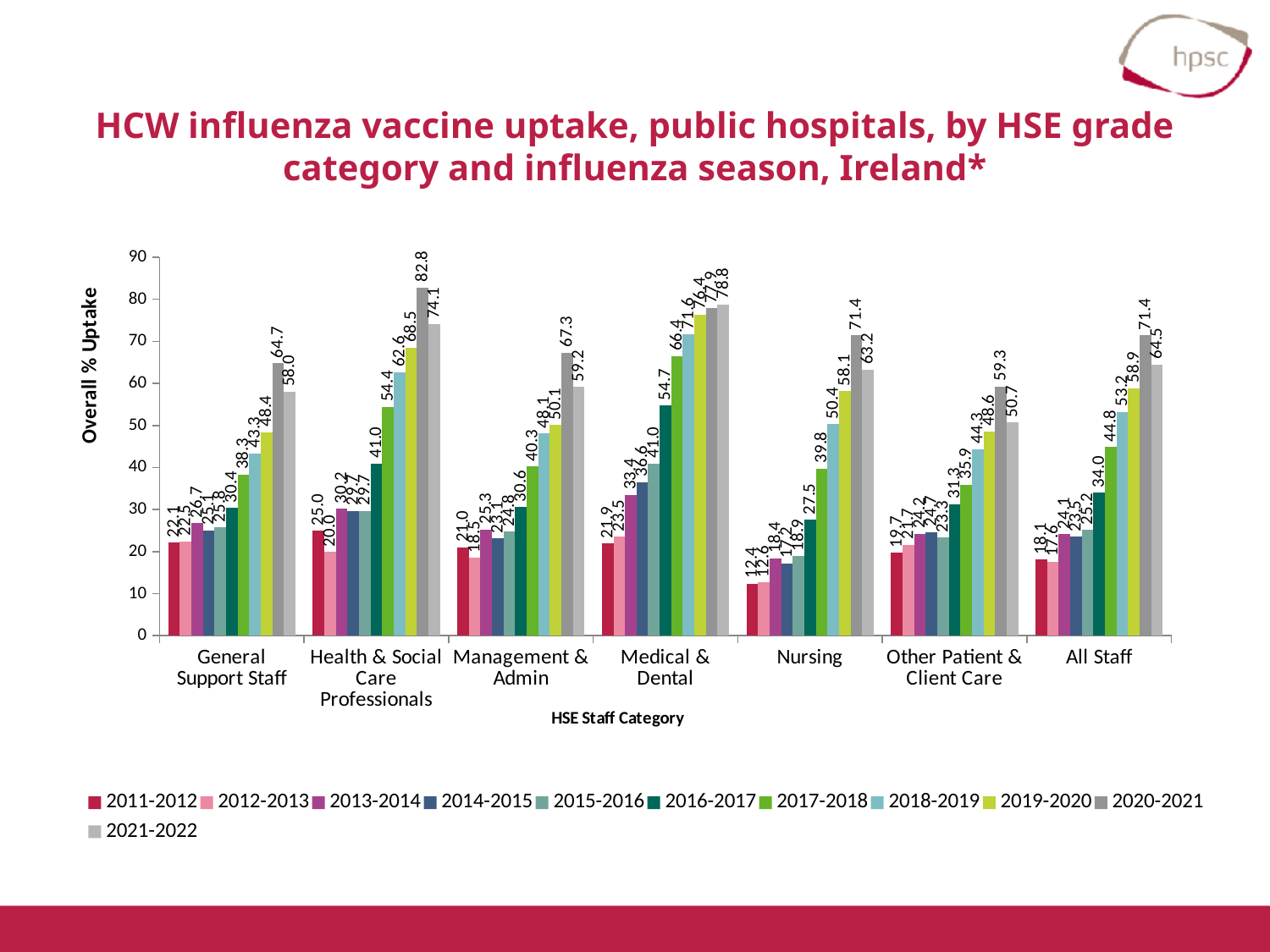
Which staff category has the lowest uptake in the 2011-2012 season? Nursing How many HSE staff categories are shown on the x axis? 7 Which staff category has the highest uptake in the 2020-2021 season? Health & Social Care Professionals For Medical & Dental, do the uptake values rise or fall from the 2011-2012 season to the 2021-2022 season? Rise What is the overall % uptake for Nursing in the 2021-2022 season? 63.2 What is the label on the vertical axis? Overall % Uptake What kind of chart is shown on the slide? Bar chart What is the overall % uptake for All Staff in the 2020-2021 season? 71.4 In the 2021-2022 season, which has the higher uptake: Medical & Dental or Health & Social Care Professionals? Medical & Dental For All Staff, how much higher is the 2020-2021 uptake than the 2021-2022 uptake? 6.9 What is the overall % uptake for Medical & Dental in the 2021-2022 season? 78.8 How many influenza seasons does the legend list? 11